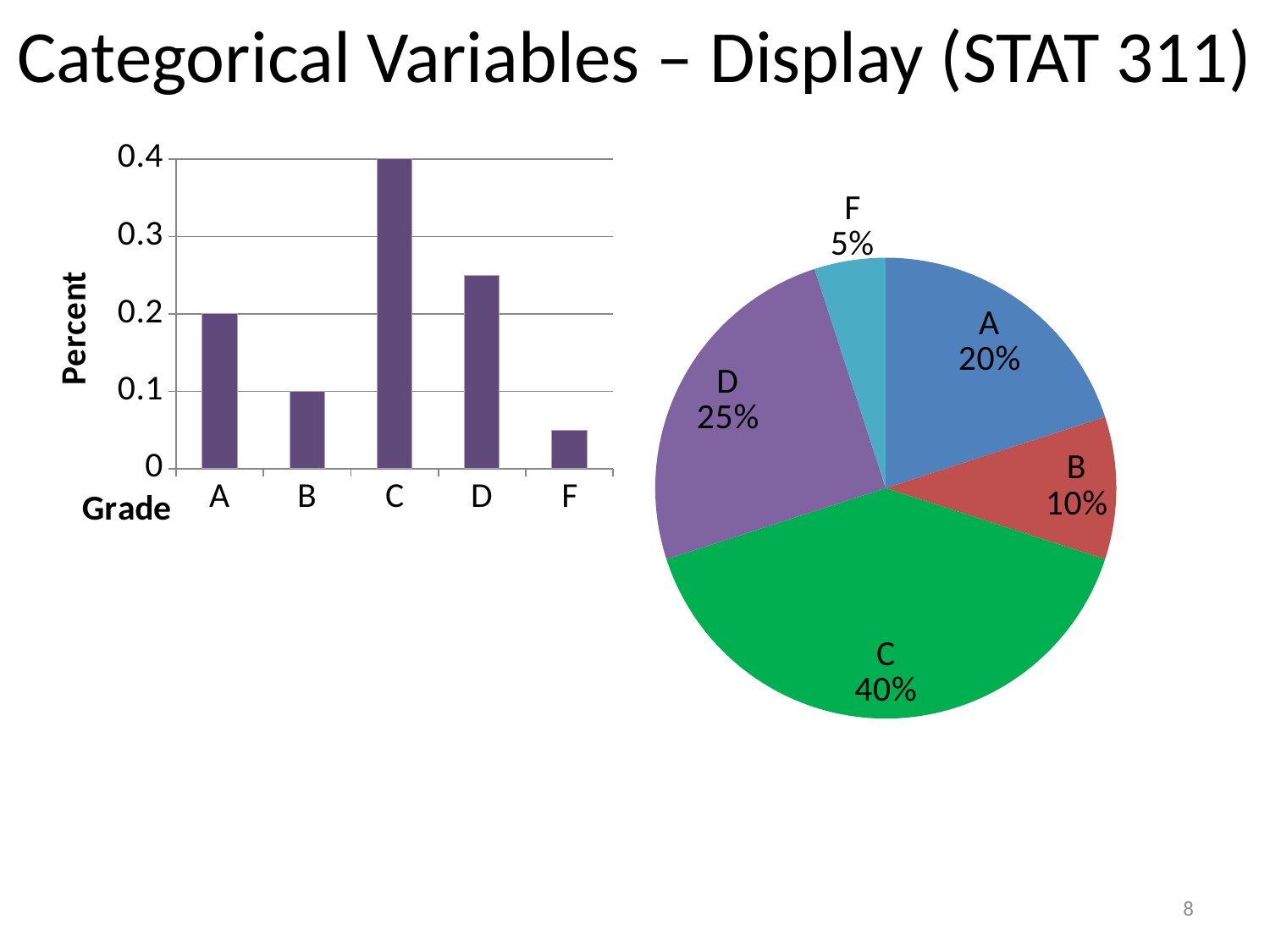
In the bar chart on the left, which grade has the highest bar? C In the bar chart on the left, is the value for grade F greater or less than 0.1? less In the bar chart on the left, which grade has the lowest bar? F In the bar chart on the left, how many grade categories are shown on the x axis? 5 In the bar chart on the left, what is the Percent value for grade C? 0.4 In the bar chart on the left, what is the Percent value for grade A? 0.2 In the pie chart on the right, which is larger, the slice for grade A or the slice for grade F? A In the pie chart on the right, what share does grade D have? 25% In the pie chart on the right, what is the difference between the shares for grade C and grade B? 30% In the bar chart on the left, is the value for grade D greater or less than 0.2? greater In the bar chart on the left, what is the label on the vertical axis? Percent What kind of chart is the chart on the left of the slide? bar chart